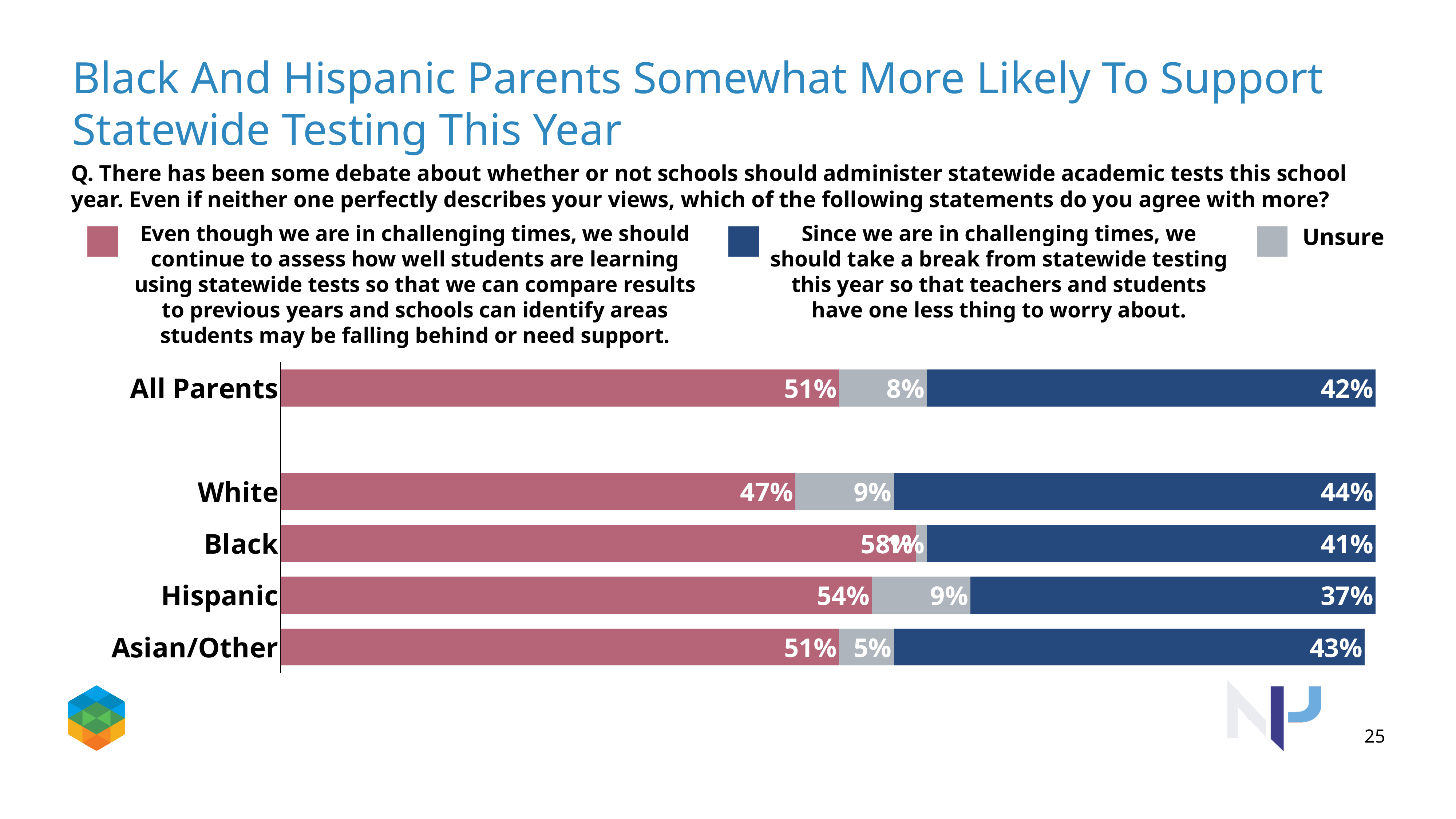
Which parent group has the lowest share supporting taking a break from statewide testing? Hispanic What is the Unsure percentage for Asian/Other parents? 5% What percentage of White parents agree that schools should take a break from statewide testing this year? 44% What percentage of All Parents are Unsure? 8% Which parent group has the highest share supporting continuing statewide testing? Black What percentage of Hispanic parents agree that schools should continue statewide testing this year? 54% How many series does the legend list? 3 What colour represents the Unsure responses in the chart? gray How many parent groups are shown on the chart? 5 Which is larger: the share of Asian/Other parents who support taking a break from testing, or the share of Hispanic parents who do? Asian/Other What kind of chart is shown on the slide? stacked bar chart What is the difference between the share of Black parents and White parents who support continuing statewide testing? 11%